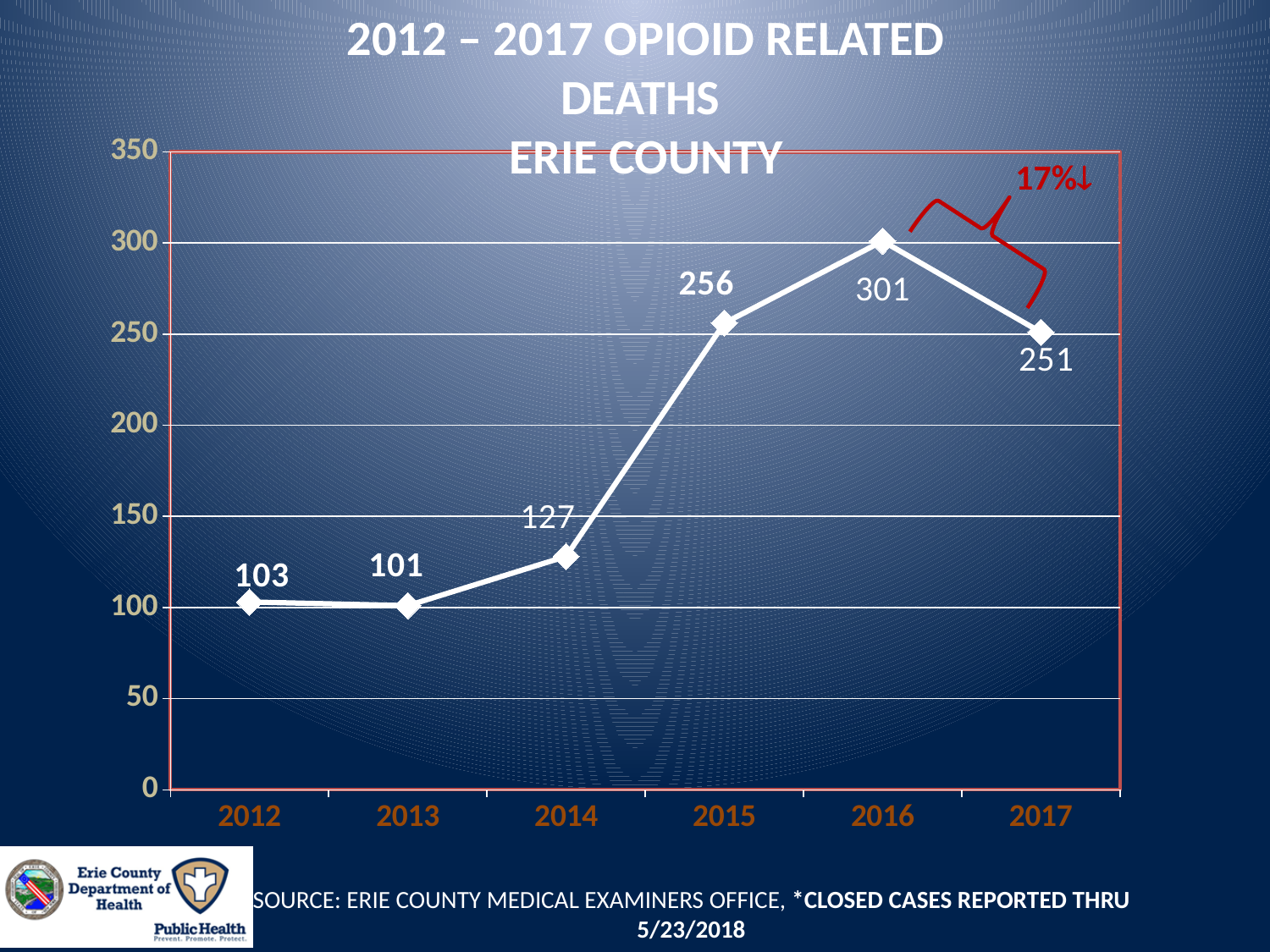
Which year had more opioid related deaths, 2015 or 2017? 2015 What was the number of opioid related deaths in Erie County in 2016? 301 How many years are plotted on the chart? 6 What kind of chart is shown on the slide? Line chart What value is shown for 2014? 127 How much higher is the 2015 value than the 2014 value? 129 Which year had the lowest number of opioid related deaths? 2013 What is the difference between the 2016 and 2017 values? 50 What percentage change is annotated in red between 2016 and 2017? 17%↓ Did the number of opioid related deaths rise or fall from 2016 to 2017? Fall What was the number of opioid related deaths in 2012? 103 Which year had the highest number of opioid related deaths? 2016